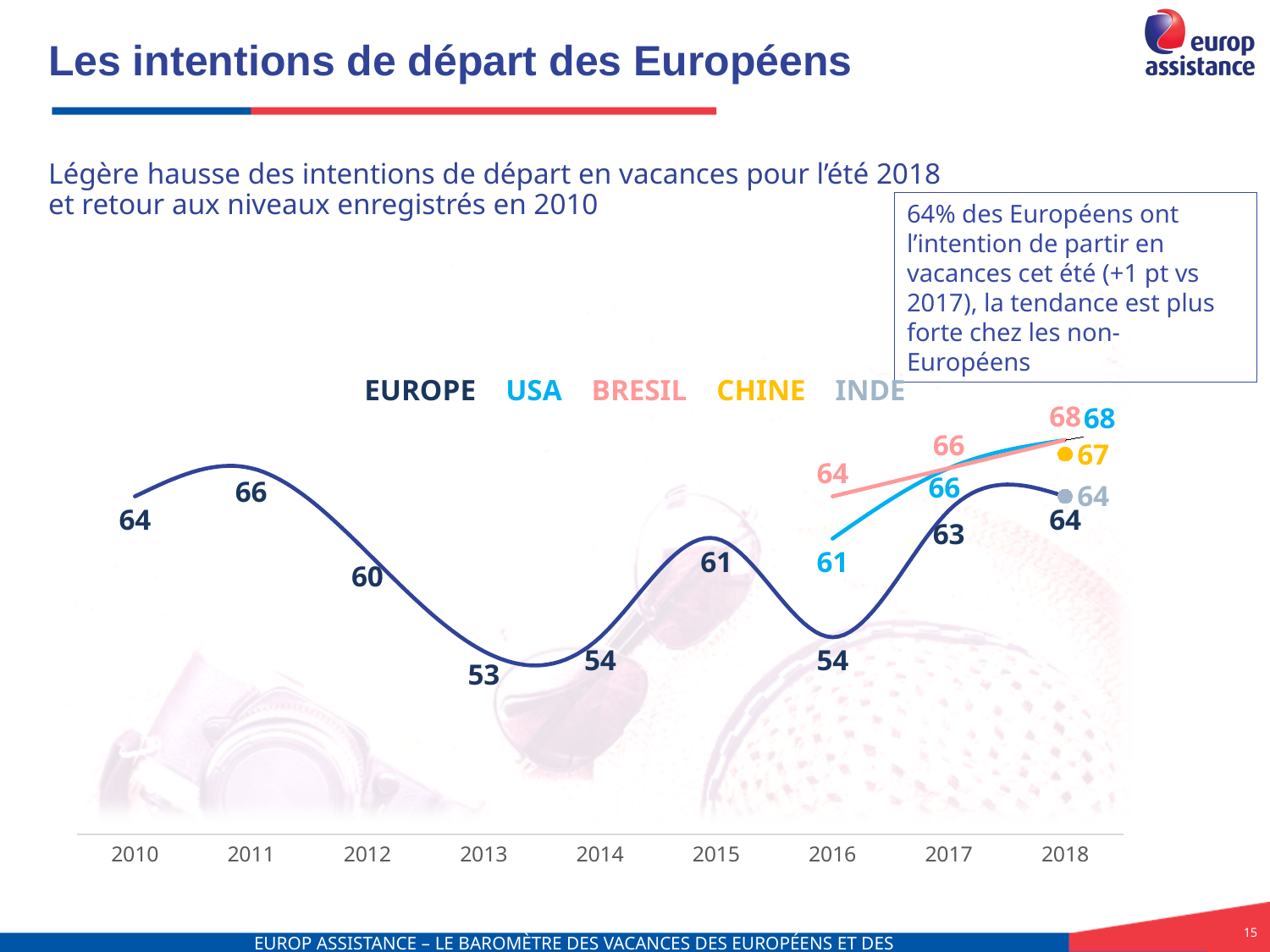
How many series does the legend list? 5 In which year is the EUROPE series at its highest? 2011 What kind of chart is shown on the slide? Line chart How many years are shown on the x axis? 9 Which is larger in 2018, the USA value or the EUROPE value? USA In which year is the EUROPE series at its lowest? 2013 What is the difference between the EUROPE value in 2011 and in 2013? 13 What is the value for USA in 2016? 61 What is the value for EUROPE in 2013? 53 What is the value for CHINE in 2018? 67 Does the EUROPE series rise or fall from 2016 to 2018? Rise What is the difference between the EUROPE value in 2018 and in 2017? 1